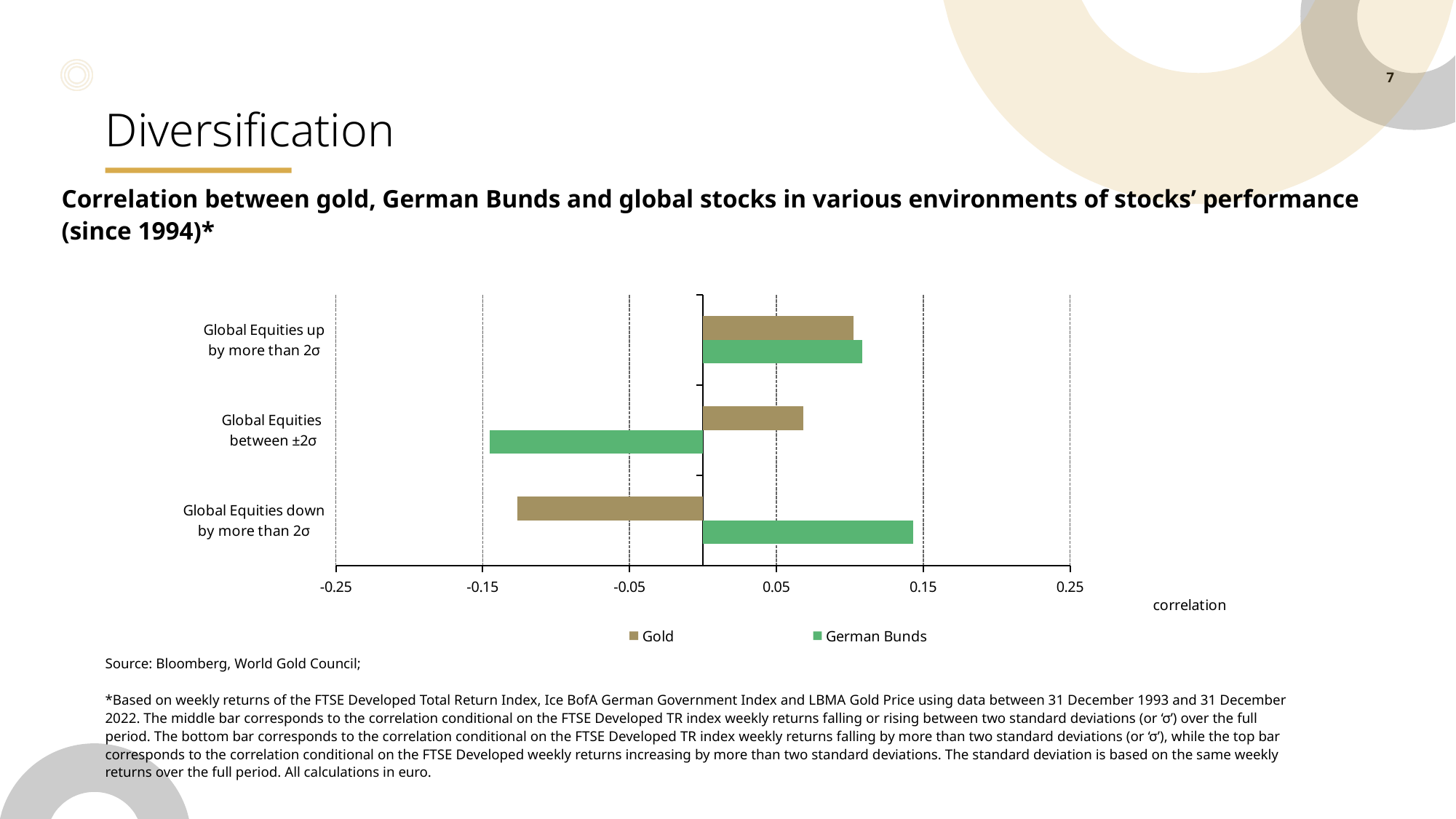
For which category is the German Bunds correlation highest? Global Equities down by more than 2σ Is the Gold value for 'Global Equities up by more than 2σ' greater or less than 0.05? greater For 'Global Equities between ±2σ', which series has the larger correlation, Gold or German Bunds? Gold Is the German Bunds value for 'Global Equities between ±2σ' greater or less than -0.05? less What kind of chart is shown on the slide? bar chart How many series does the legend list? 2 Which two series are listed in the chart legend? Gold and German Bunds Is the German Bunds value for 'Global Equities down by more than 2σ' greater or less than 0.05? greater What label is shown on the horizontal axis of the chart? correlation For which category is the Gold correlation lowest? Global Equities down by more than 2σ How many categories are shown on the chart? 3